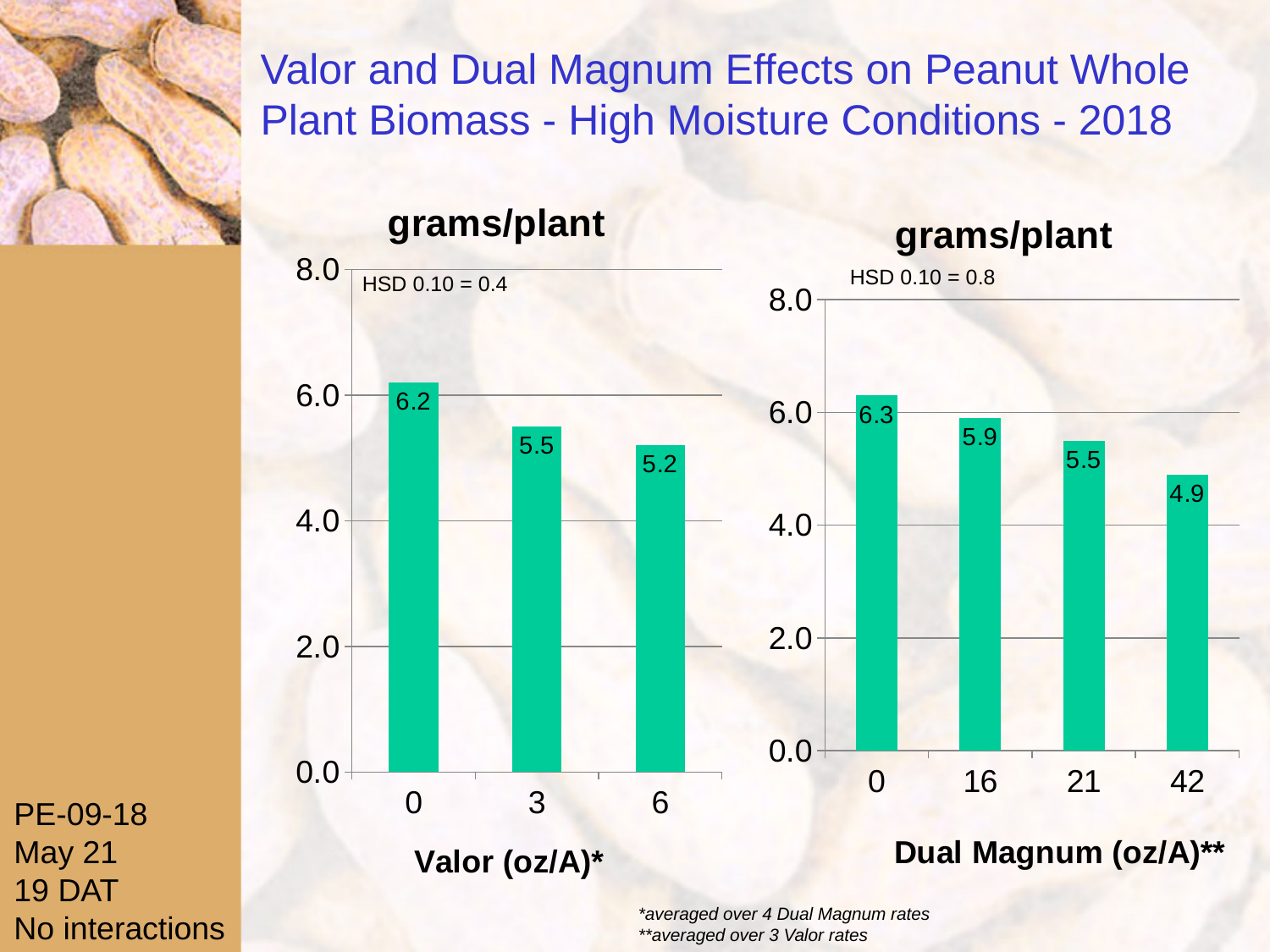
In the right chart (Dual Magnum), which rate has the larger grams/plant value, 16 or 21? 16 In the right chart (Dual Magnum), do the grams/plant values rise or fall as the rate increases? Fall What type of chart is used on this slide? Bar chart In the left chart (Valor), what is the grams/plant value at the 0 oz/A rate? 6.2 In the right chart (Dual Magnum), which rate has the highest grams/plant value? 0 In the right chart (Dual Magnum), what is the difference in grams/plant between the 0 and 42 oz/A rates? 1.4 In the left chart (Valor), what is the difference in grams/plant between the 0 and 6 oz/A rates? 1.0 In the right chart (Dual Magnum), what is the grams/plant value at the 42 oz/A rate? 4.9 In the left chart (Valor), which rate has the lowest grams/plant value? 6 How many bars are in the left chart (Valor)? 3 In the right chart (Dual Magnum), what is the grams/plant value at the 16 oz/A rate? 5.9 How many bars are in the right chart (Dual Magnum)? 4